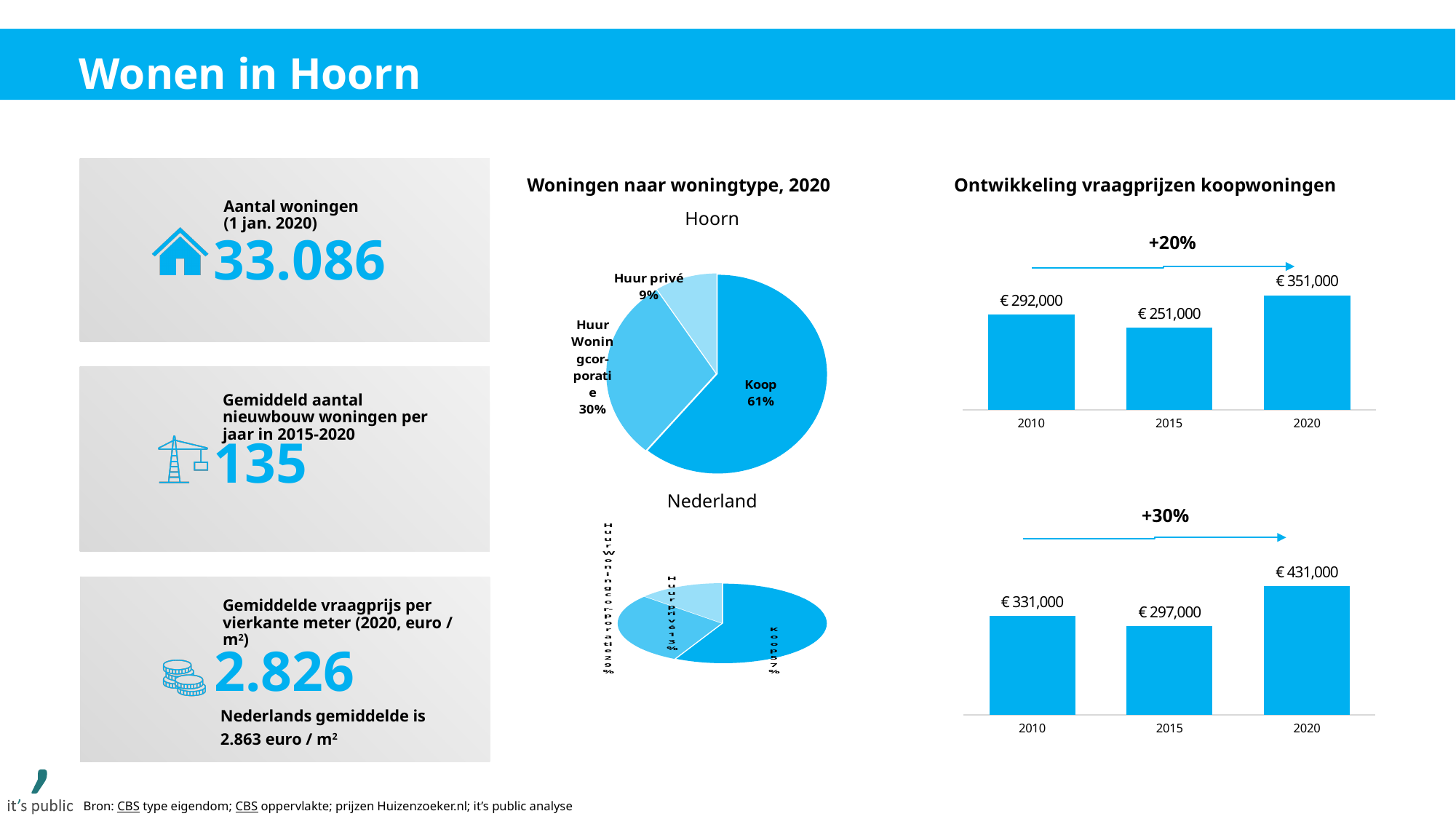
In the Hoorn pie chart, which category has the smallest slice? Huur privé In the upper bar chart under 'Ontwikkeling vraagprijzen koopwoningen', what is the value for 2015? € 251,000 In the Hoorn pie chart, what share of homes is 'Koop'? 61% In the upper bar chart under 'Ontwikkeling vraagprijzen koopwoningen', which year has the highest value? 2020 In the upper bar chart under 'Ontwikkeling vraagprijzen koopwoningen', what is the difference between the 2020 and 2010 values? € 59,000 In the Hoorn pie chart, what share of homes is 'Huur privé'? 9% What kind of chart is used to show 'Woningen naar woningtype, 2020' for Hoorn? Pie chart In the Hoorn pie chart, which category has the largest slice? Koop How many slices does the Hoorn pie chart have? 3 In the lower bar chart under 'Ontwikkeling vraagprijzen koopwoningen', what is the value for 2020? € 431,000 In the lower bar chart under 'Ontwikkeling vraagprijzen koopwoningen', is the value for 2010 larger or smaller than the value for 2015? Larger In the lower bar chart under 'Ontwikkeling vraagprijzen koopwoningen', which year has the lowest value? 2015